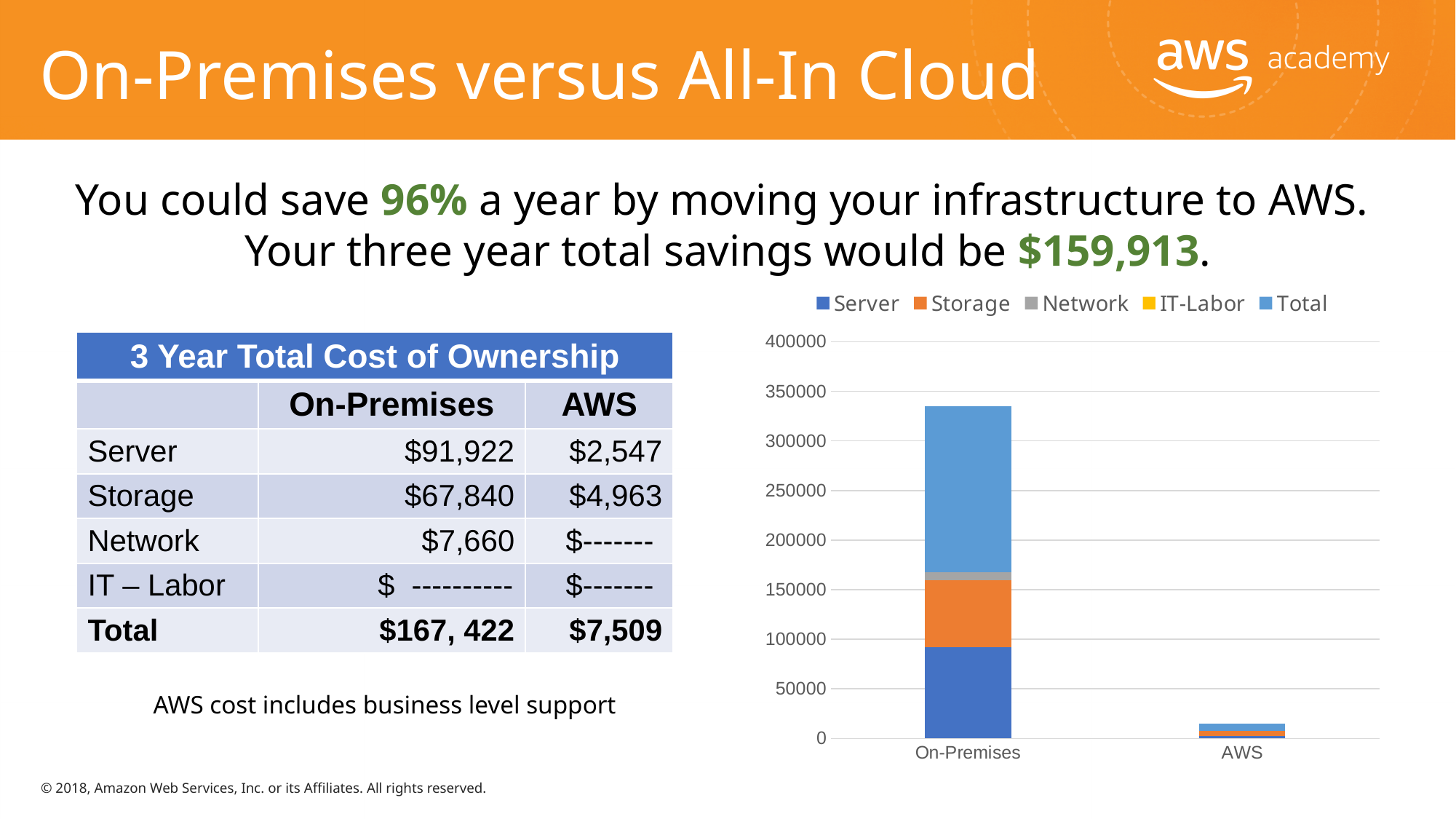
What kind of chart is shown on the slide? stacked bar chart Is the total height of the On-Premises stacked bar greater or less than 350000? less How many series does the chart legend list? 5 How many categories are shown on the x axis of the chart? 2 Is the total height of the AWS stacked bar greater or less than 50000? less Is the Server segment of the On-Premises bar greater or less than 50000? greater Which series in the chart legend is shown in orange? Storage What is the highest value shown on the chart's y axis? 400000 Which category has the taller stacked bar, On-Premises or AWS? On-Premises Which category has the lowest stacked bar in the chart? AWS